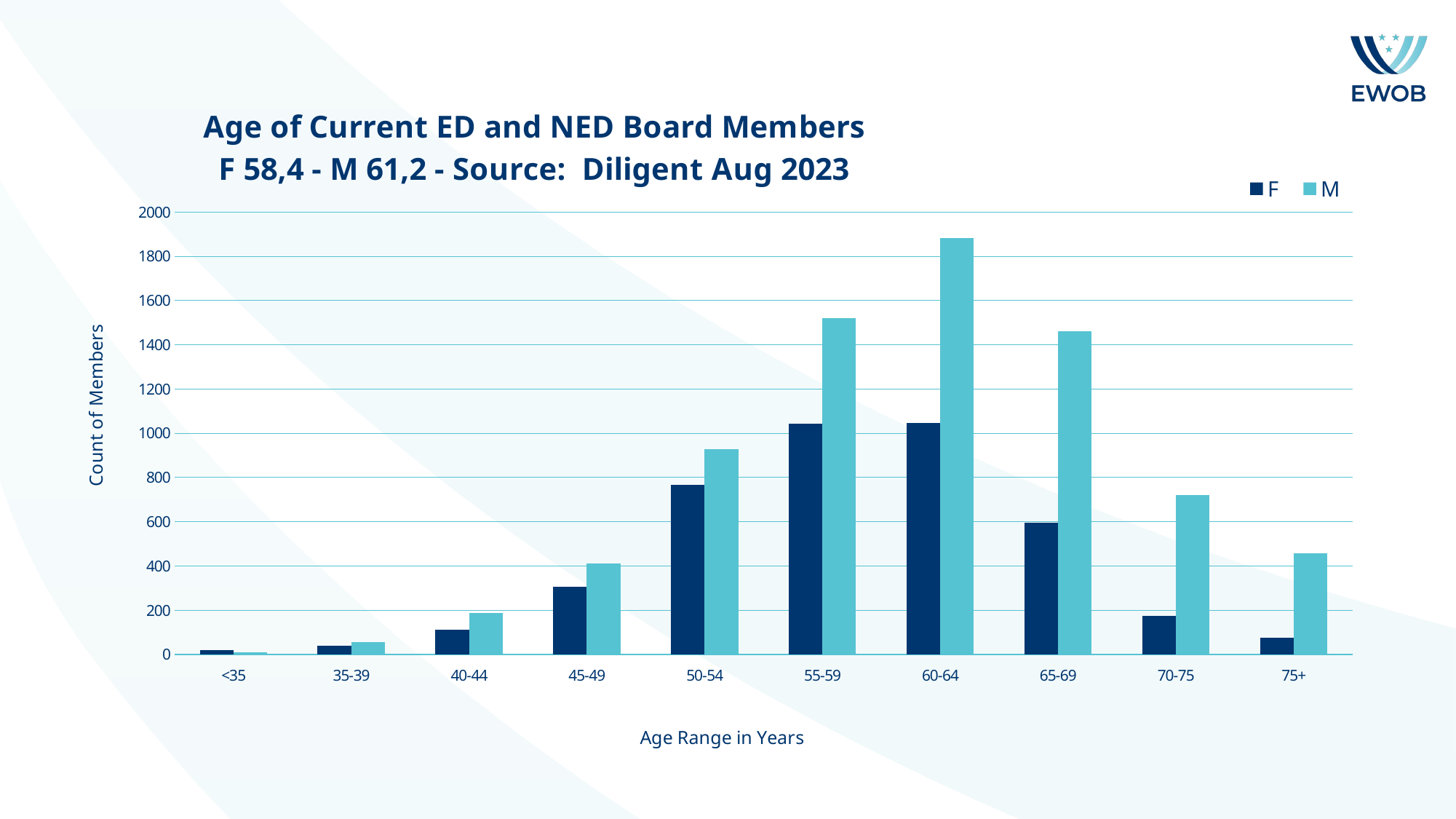
Is the value for M in the 70-75 age range greater or less than 600? greater What kind of chart is shown on the slide? bar chart What is the label of the y axis? Count of Members In the 65-69 age range, which series has the larger value, F or M? M Is the value for F in the 45-49 age range greater or less than 200? greater Which age range has the highest value for the M series? 60-64 Is the value for F in the 50-54 age range greater or less than 800? less Which age range has the lowest value for the M series? <35 How many age range categories are shown on the x axis? 10 Do the M values rise or fall from the <35 age range to the 60-64 age range? rise How many series does the legend list? 2